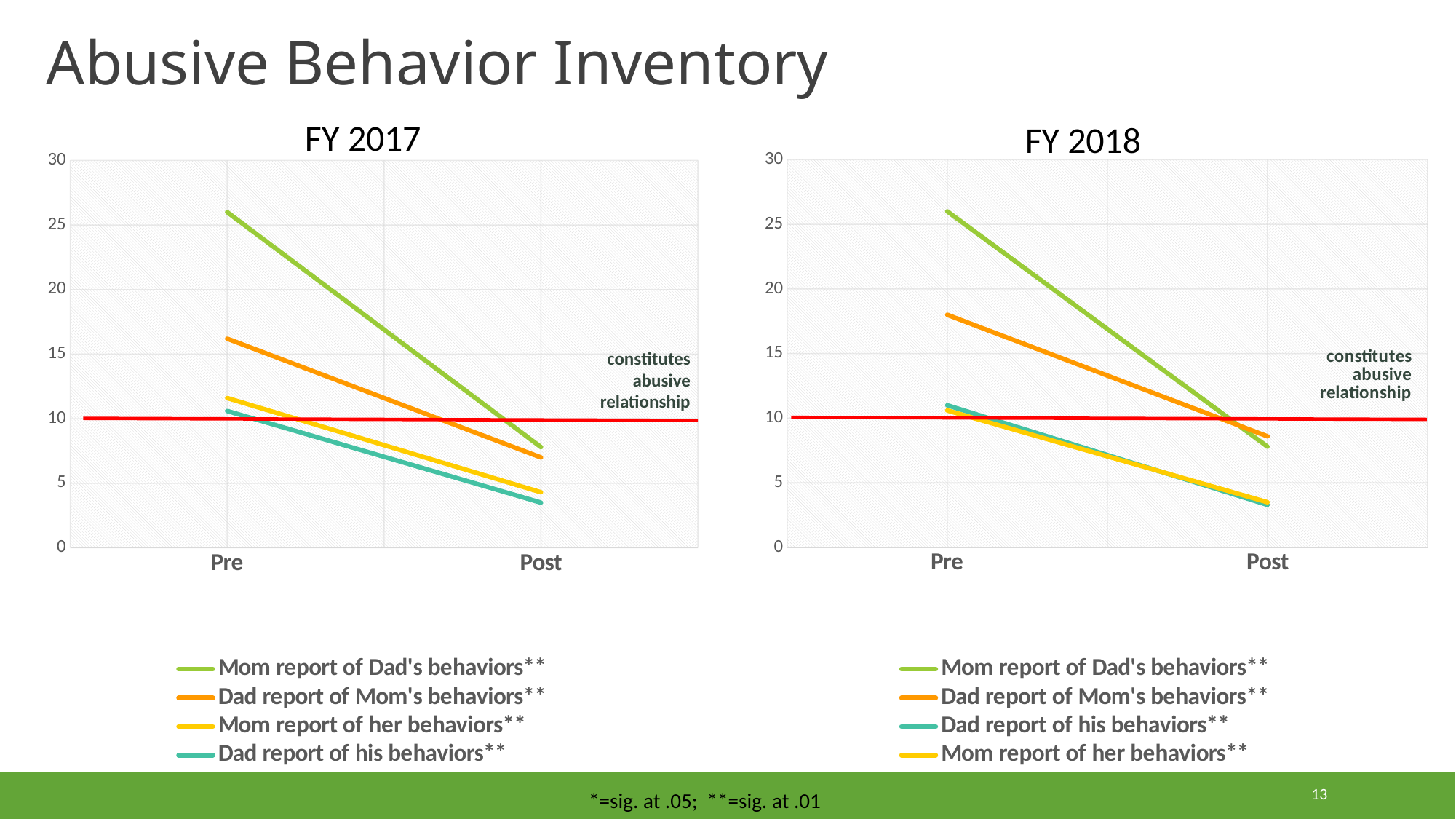
In the FY 2018 chart, which is larger at Pre: Mom report of Dad's behaviors or Dad report of Mom's behaviors? Mom report of Dad's behaviors In the FY 2017 chart, does the value for Mom report of Dad's behaviors rise or fall from Pre to Post? fall What does the red horizontal line in the FY 2018 chart represent, according to its label? constitutes abusive relationship In the FY 2017 chart, is the Pre value for Dad report of Mom's behaviors greater or less than 15? greater In the FY 2017 chart, which series has the lowest value at Post? Dad report of his behaviors What kind of chart is the FY 2017 chart? line chart How many series does the legend of the FY 2018 chart list? 4 In the FY 2017 chart, which series has the highest value at Pre? Mom report of Dad's behaviors In the FY 2018 chart, is the Post value for Dad report of Mom's behaviors greater or less than 10? less In the FY 2018 chart, is the Pre value for Mom report of Dad's behaviors greater or less than 25? greater How many categories are on the x axis of the FY 2017 chart? 2